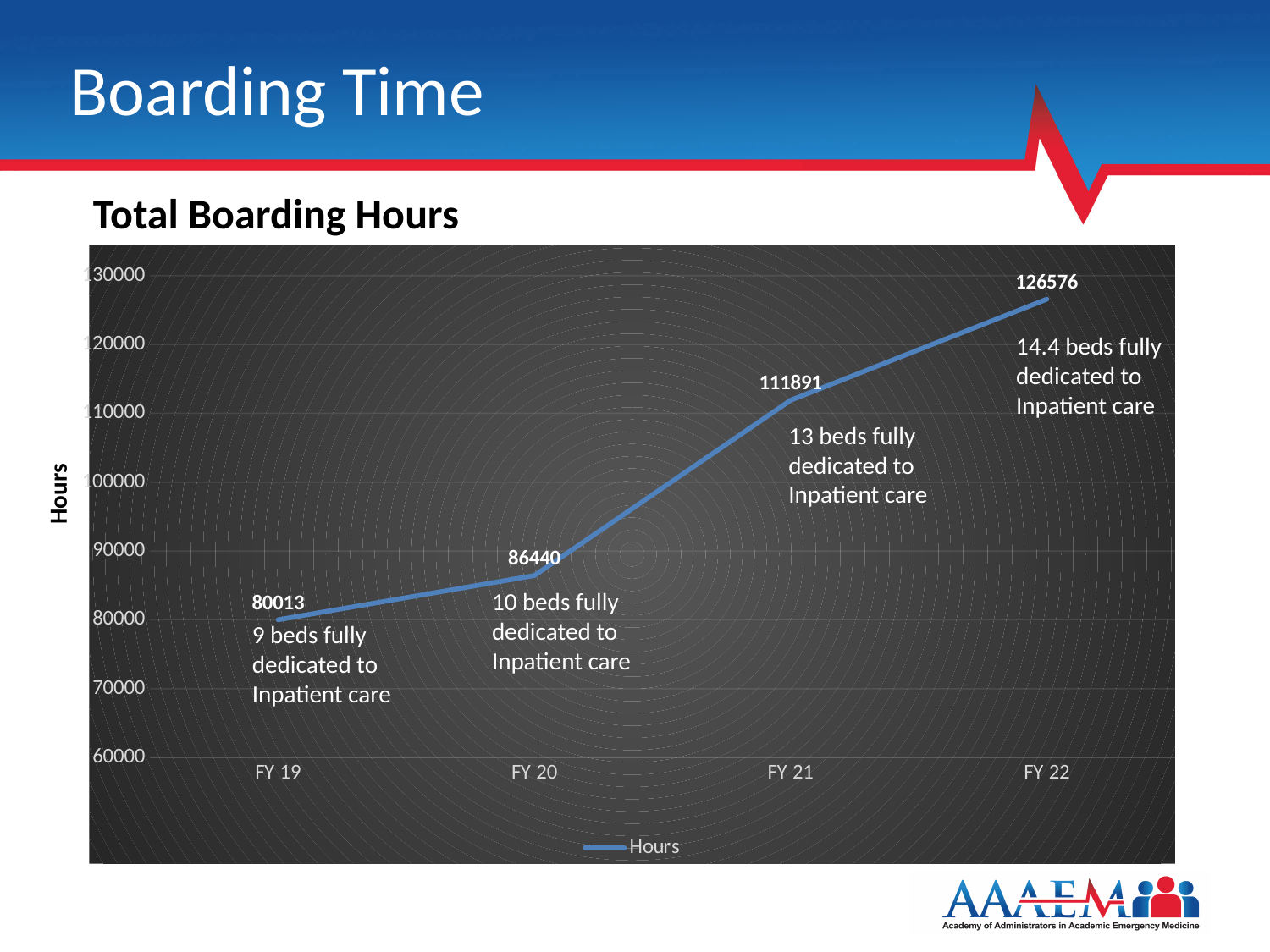
How many fiscal years are plotted in the Total Boarding Hours chart? 4 What is the value for FY 21 in the Total Boarding Hours chart? 111891 What is the value for FY 19 in the Total Boarding Hours chart? 80013 What is the difference in boarding hours between FY 22 and FY 19? 46563 Which fiscal year has the lowest total boarding hours? FY 19 What is the value for FY 20 in the Total Boarding Hours chart? 86440 Which fiscal year has the highest total boarding hours? FY 22 What kind of chart is used to show Total Boarding Hours? Line chart What is the value for FY 22 in the Total Boarding Hours chart? 126576 Do the total boarding hours rise or fall from FY 19 to FY 22? Rise Which has more boarding hours, FY 20 or FY 21? FY 21 What is the difference in boarding hours between FY 21 and FY 20? 25451